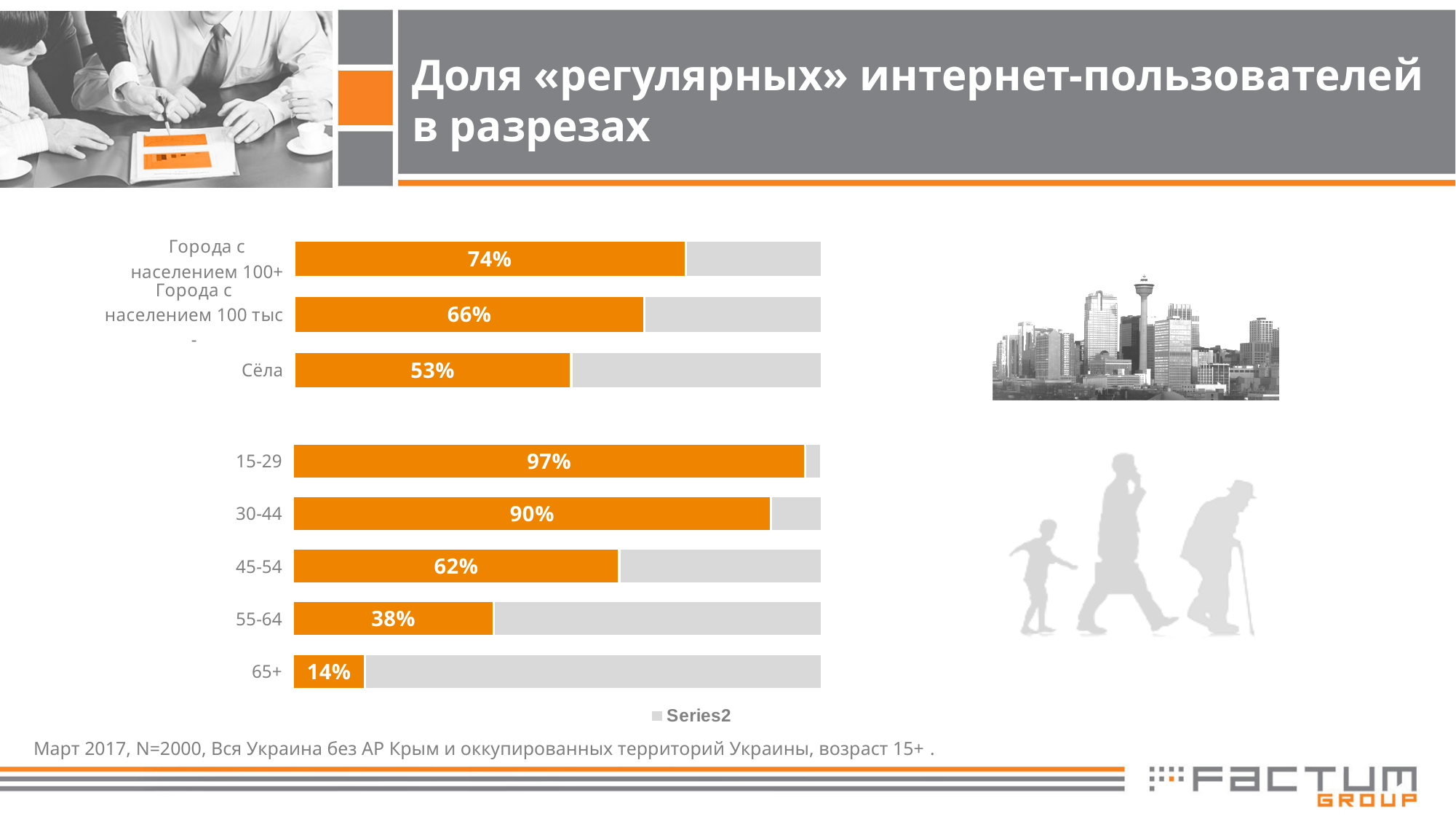
How many categories are plotted on the chart? 8 Which category has the highest value on the chart? 15-29 What is the difference between the values for Города с населением 100+ and Сёла? 21% Which category has the lowest value on the chart? 65+ What is the difference between the values for 30-44 and 55-64? 52% What is the value for Сёла? 53% What kind of chart is shown on the slide? Bar chart What entry does the chart legend show? Series2 What is the value for the 45-54 age group? 62% Which is larger, the value for 45-54 or the value for Города с населением 100 тыс -? Города с населением 100 тыс - What is the value for the 15-29 age group? 97% What is the value for the 65+ age group? 14%